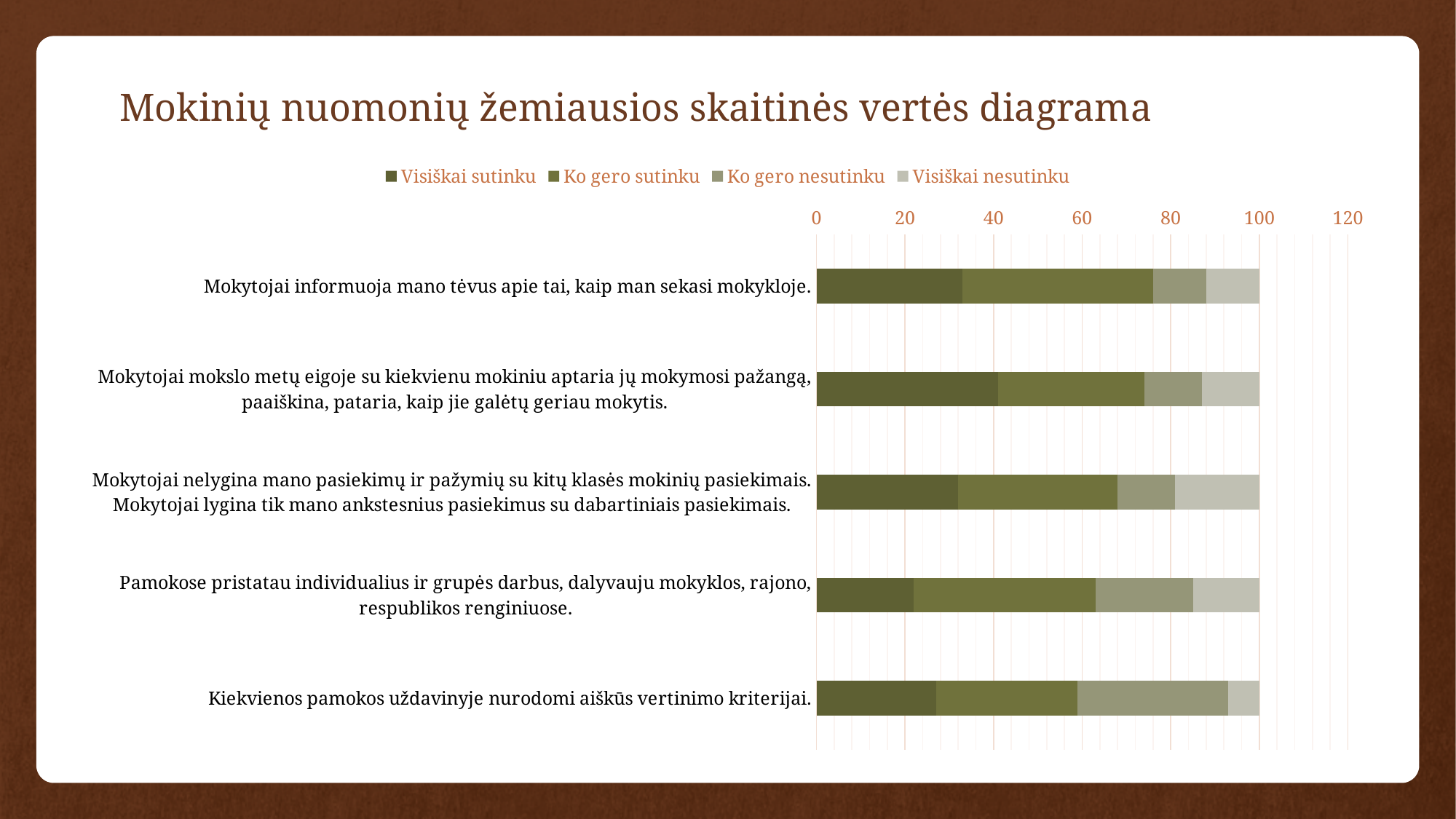
What is the title of the chart? Mokinių nuomonių žemiausios skaitinės vertės diagrama What is the total of the stacked bar for "Kiekvienos pamokos uždavinyje nurodomi aiškūs vertinimo kriterijai."? 100 What kind of chart is shown on the slide? Bar chart How many categories (statements) are plotted on the chart? 5 Is the "Visiškai sutinku" value for "Pamokose pristatau individualius ir grupės darbus, dalyvauju mokyklos, rajono, respublikos renginiuose." greater or less than 40? less Which has the larger "Visiškai nesutinku" segment: "Kiekvienos pamokos uždavinyje nurodomi aiškūs vertinimo kriterijai." or "Mokytojai nelygina mano pasiekimų ir pažymių su kitų klasės mokinių pasiekimais. Mokytojai lygina tik mano ankstesnius pasiekimus su dabartiniais pasiekimais."? Mokytojai nelygina mano pasiekimų ir pažymių su kitų klasės mokinių pasiekimais. Mokytojai lygina tik mano ankstesnius pasiekimus su dabartiniais pasiekimais. Is the "Visiškai sutinku" value for "Mokytojai informuoja mano tėvus apie tai, kaip man sekasi mokykloje." greater or less than 40? less Which category has the largest "Visiškai sutinku" segment? Mokytojai mokslo metų eigoje su kiekvienu mokiniu aptaria jų mokymosi pažangą, paaiškina, pataria, kaip jie galėtų geriau mokytis. Which legend entry is listed first? Visiškai sutinku Is the "Visiškai nesutinku" value for "Kiekvienos pamokos uždavinyje nurodomi aiškūs vertinimo kriterijai." greater or less than 20? less How many series does the legend list? 4 Which category has the smallest "Visiškai sutinku" segment? Pamokose pristatau individualius ir grupės darbus, dalyvauju mokyklos, rajono, respublikos renginiuose.